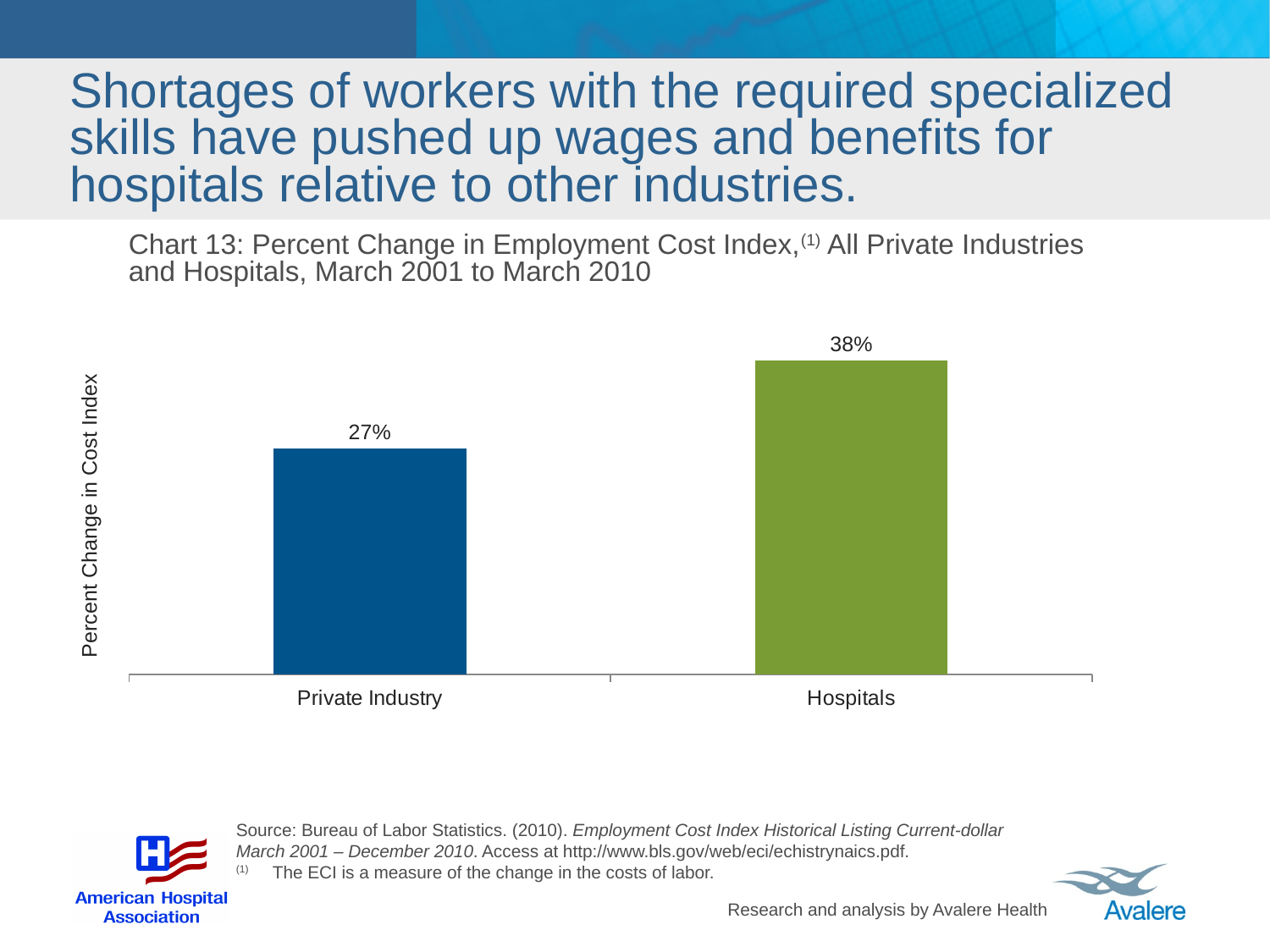
What is the percent change in the Employment Cost Index for Private Industry? 27% What is the percent change in the Employment Cost Index for Hospitals? 38% Which category has the lower percent change in cost index? Private Industry What is the label of the vertical axis? Percent Change in Cost Index What kind of chart is shown on the slide? bar chart What time period does the chart title say the percent change covers? March 2001 to March 2010 How many categories are shown on the chart? 2 What is the difference in percentage points between the Hospitals and Private Industry values? 11 percentage points Which category has the higher percent change in cost index? Hospitals Is the value for Hospitals larger or smaller than the value for Private Industry? larger